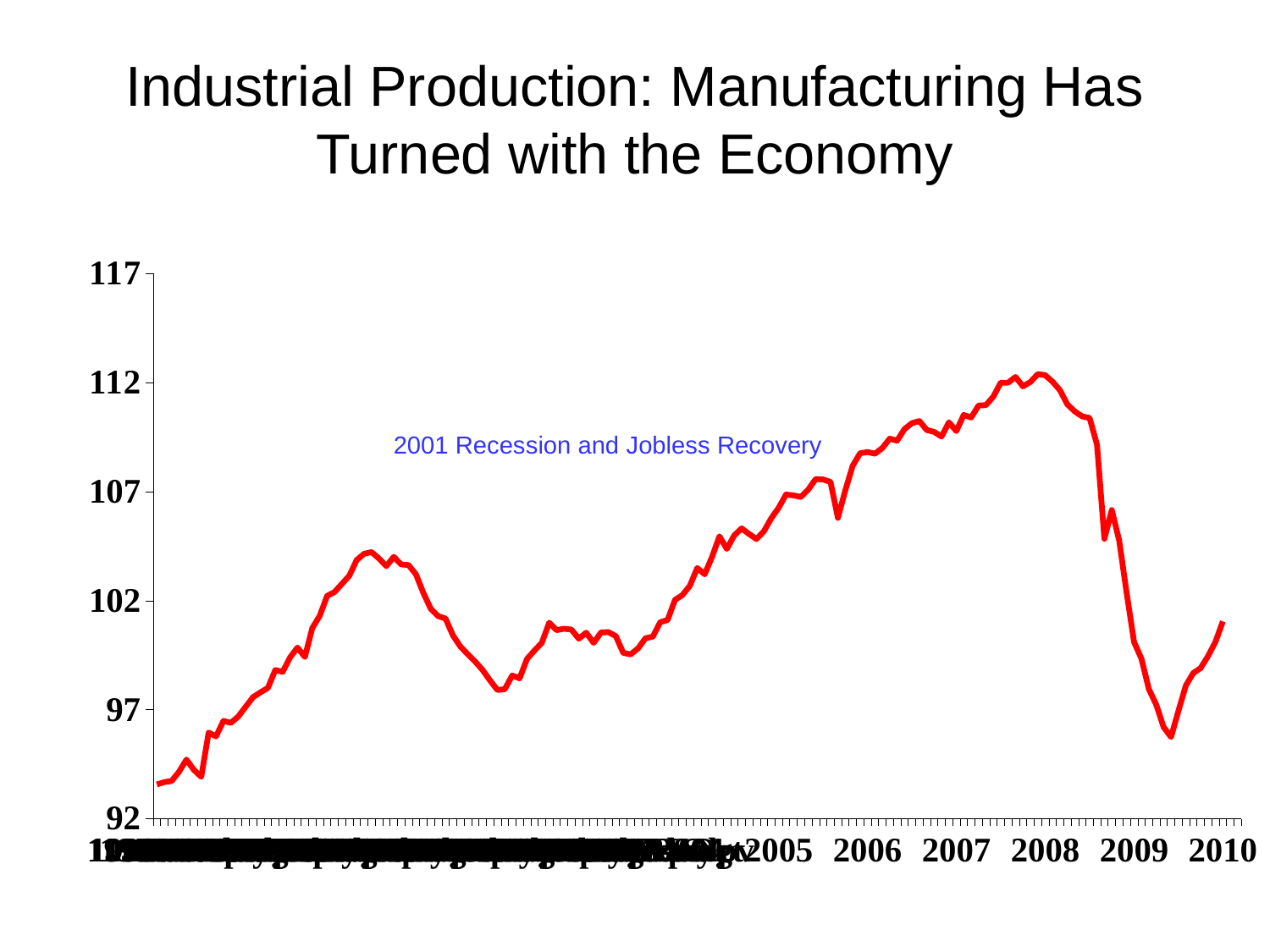
What colour is the plotted line? red Is the value at the 2010 tick greater or less than 102? less Is the value at the 2007 tick greater or less than 107? greater What annotation text is printed inside the chart area? 2001 Recession and Jobless Recovery Does the line rise or fall between the 2008 tick and the 2009 tick? fall Is the value at the 2008 tick greater or less than 107? greater Of the labelled years 2005 through 2010, at which year tick is the line highest? 2008 What kind of chart is shown on the slide? line chart Does the line rise or fall from its low point in 2009 to the 2010 tick? rise